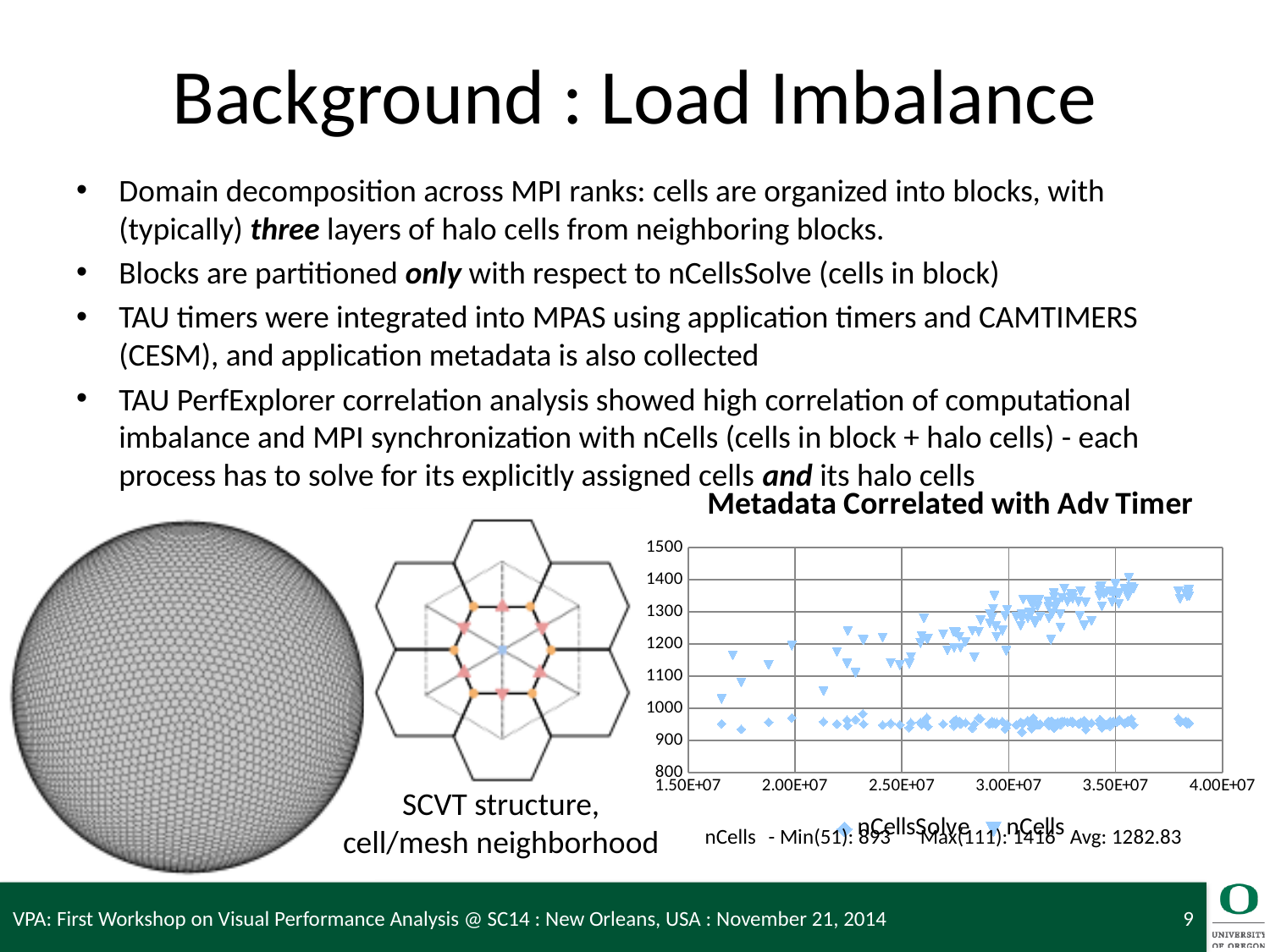
How many series does the chart's legend list? 2 Do the nCells values rise or fall as the x-axis value increases? rise What is the title of the chart on the slide? Metadata Correlated with Adv Timer Is the lowest nCellsSolve value greater or less than 900? greater What are the two series named in the chart's legend? nCellsSolve and nCells What kind of chart is shown on the slide? scatter chart Which series has the higher values overall, nCells or nCellsSolve? nCells Is the highest nCells value greater or less than 1500? less Is the highest nCells value greater or less than 1300? greater